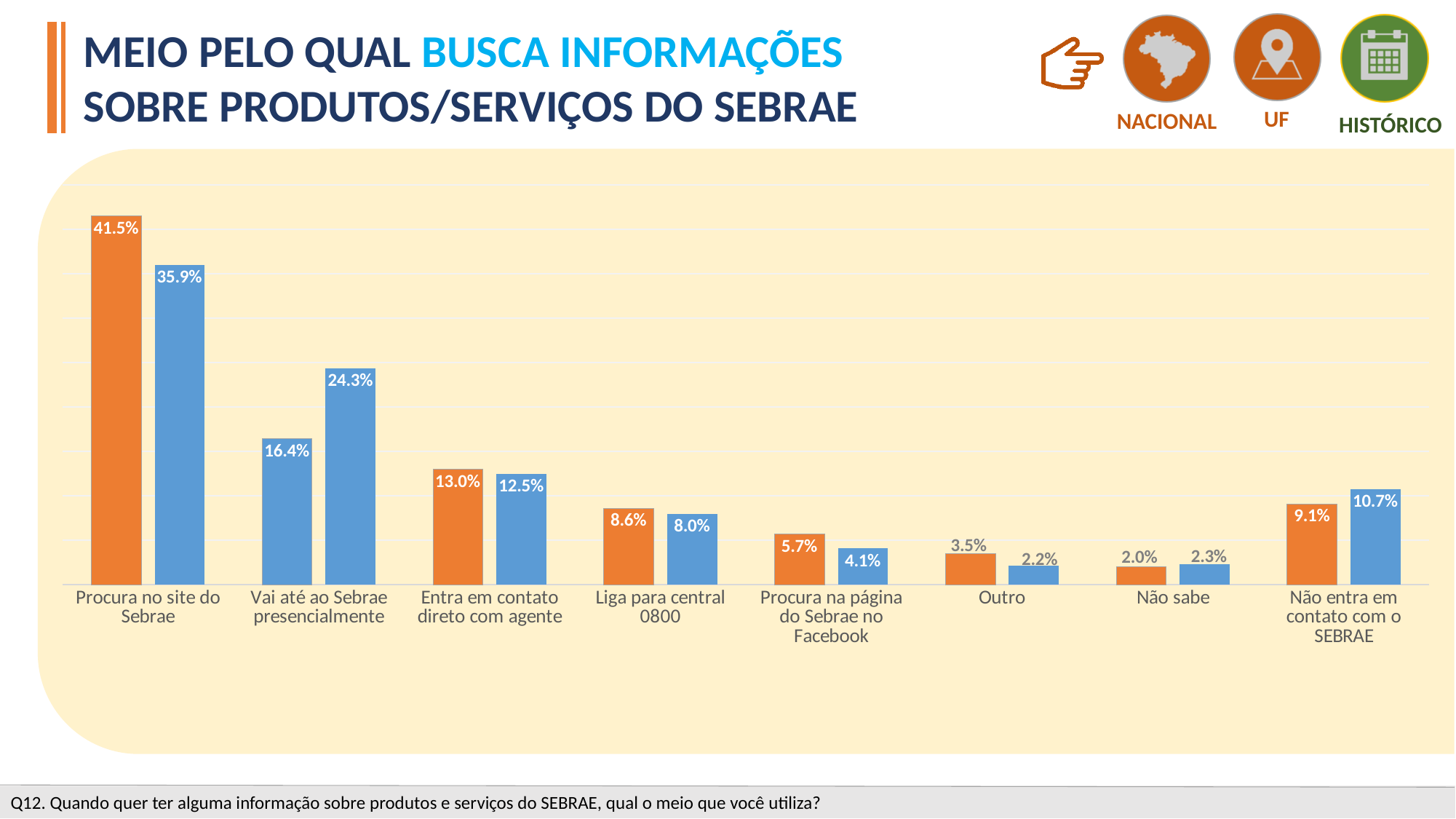
For "Vai até ao Sebrae presencialmente", which bar is larger, the orange or the blue? blue What are the two colours of the bars in the chart? orange and blue What is the difference between the orange and blue bars for "Procura no site do Sebrae"? 5.6% Which category has the lowest blue bar? Outro What is the value of the orange bar for "Procura no site do Sebrae"? 41.5% What is the value of the blue bar for "Vai até ao Sebrae presencialmente"? 24.3% What is the value of the blue bar for "Não entra em contato com o SEBRAE"? 10.7% What is the value of the orange bar for "Liga para central 0800"? 8.6% What is the difference between the orange and blue bars for "Procura na página do Sebrae no Facebook"? 1.6% Which category has the highest orange bar? Procura no site do Sebrae How many categories are shown on the x axis? 8 What kind of chart is shown on the slide? bar chart